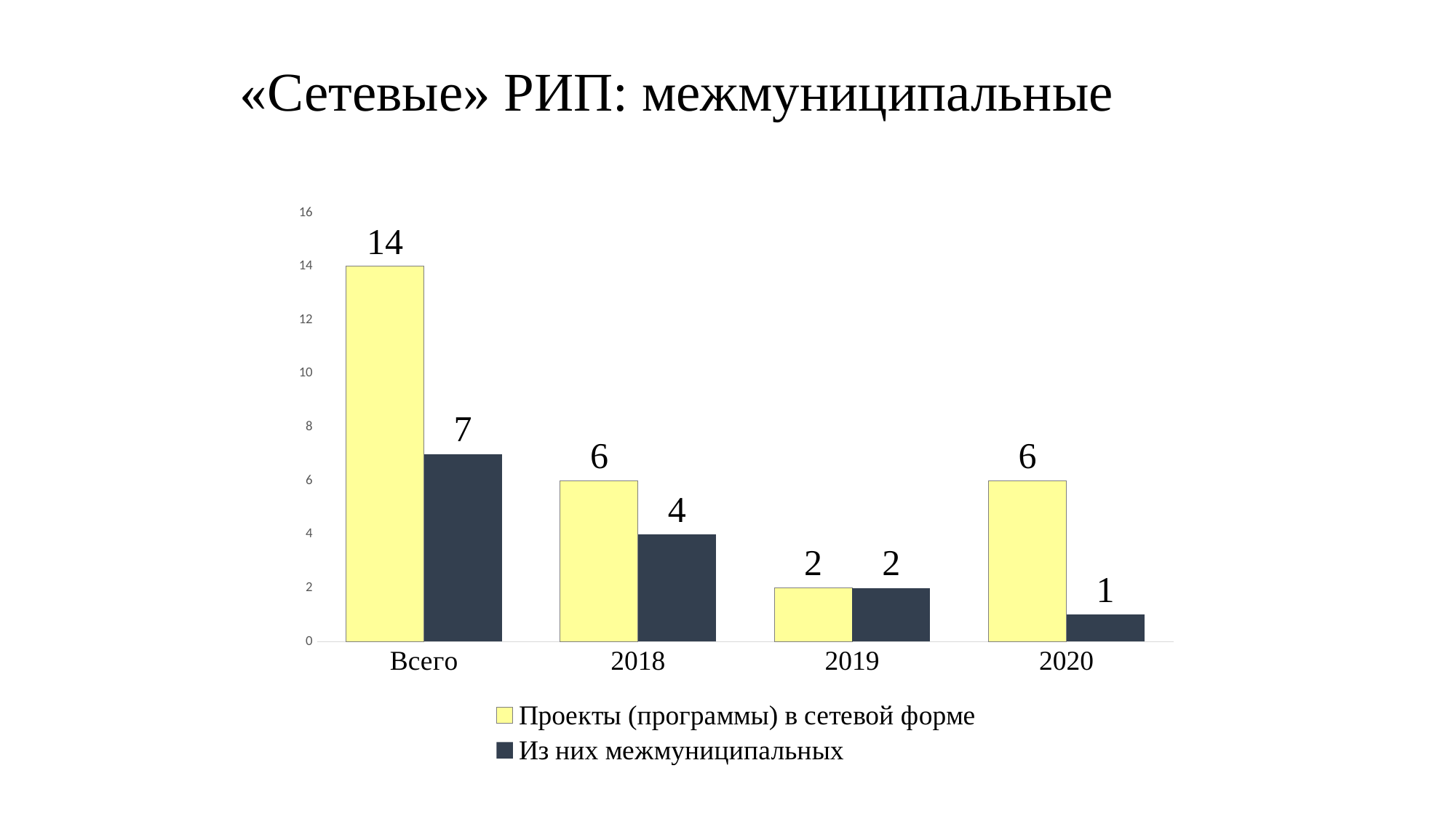
What is the value of «Из них межмуниципальных» for 2018? 4 How many categories are shown on the x axis? 4 What is the value of «Проекты (программы) в сетевой форме» for Всего? 14 Which is larger: «Из них межмуниципальных» for 2018 or for 2020? 2018 What is the difference between «Проекты (программы) в сетевой форме» and «Из них межмуниципальных» for Всего? 7 How many series does the legend list? 2 Among the years 2018, 2019 and 2020, which has the lowest value for «Проекты (программы) в сетевой форме»? 2019 What is the value of «Проекты (программы) в сетевой форме» for 2019? 2 What is the difference between «Проекты (программы) в сетевой форме» and «Из них межмуниципальных» for 2020? 5 What kind of chart is shown on the slide? Bar chart What is the value of «Из них межмуниципальных» for 2020? 1 Which category has the highest value for «Из них межмуниципальных»? Всего